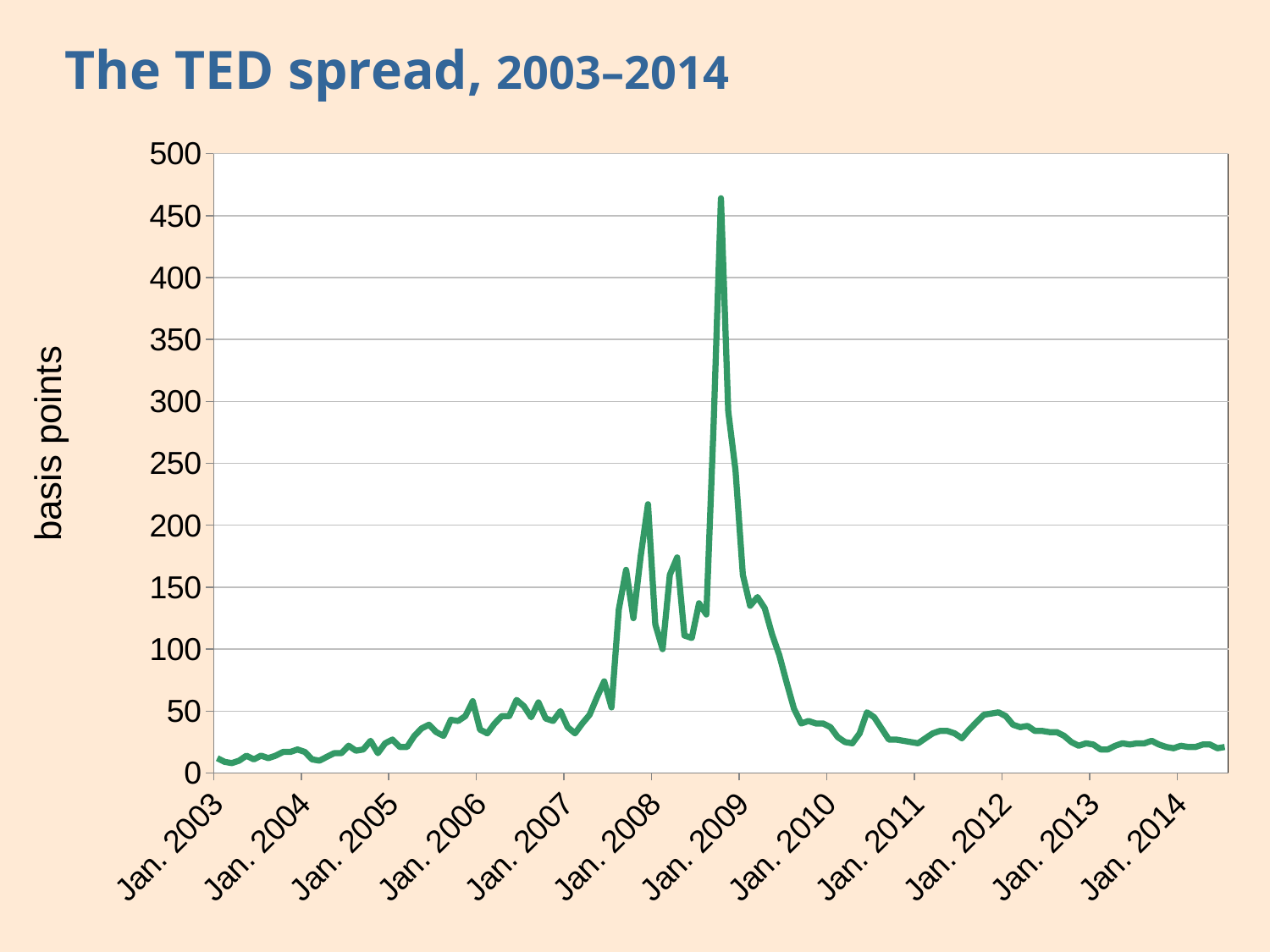
How many labelled ticks are on the x axis? 12 Which is larger, the TED spread at Jan. 2012 or at Jan. 2014? Jan. 2012 Is the peak value of the TED spread greater or less than 400? greater Which is larger, the TED spread at Jan. 2008 or at Jan. 2010? Jan. 2008 What is the title of the chart? The TED spread, 2003–2014 Is the value of the TED spread at Jan. 2003 greater or less than 50? less What kind of chart is shown on the slide? line chart Is the value of the TED spread at Jan. 2014 greater or less than 50? less Between which two labelled x-axis ticks does the highest value of the TED spread occur? Jan. 2008 and Jan. 2009 Does the TED spread rise or fall between its late-2008 peak and Jan. 2010? fall What unit is shown on the vertical axis label? basis points